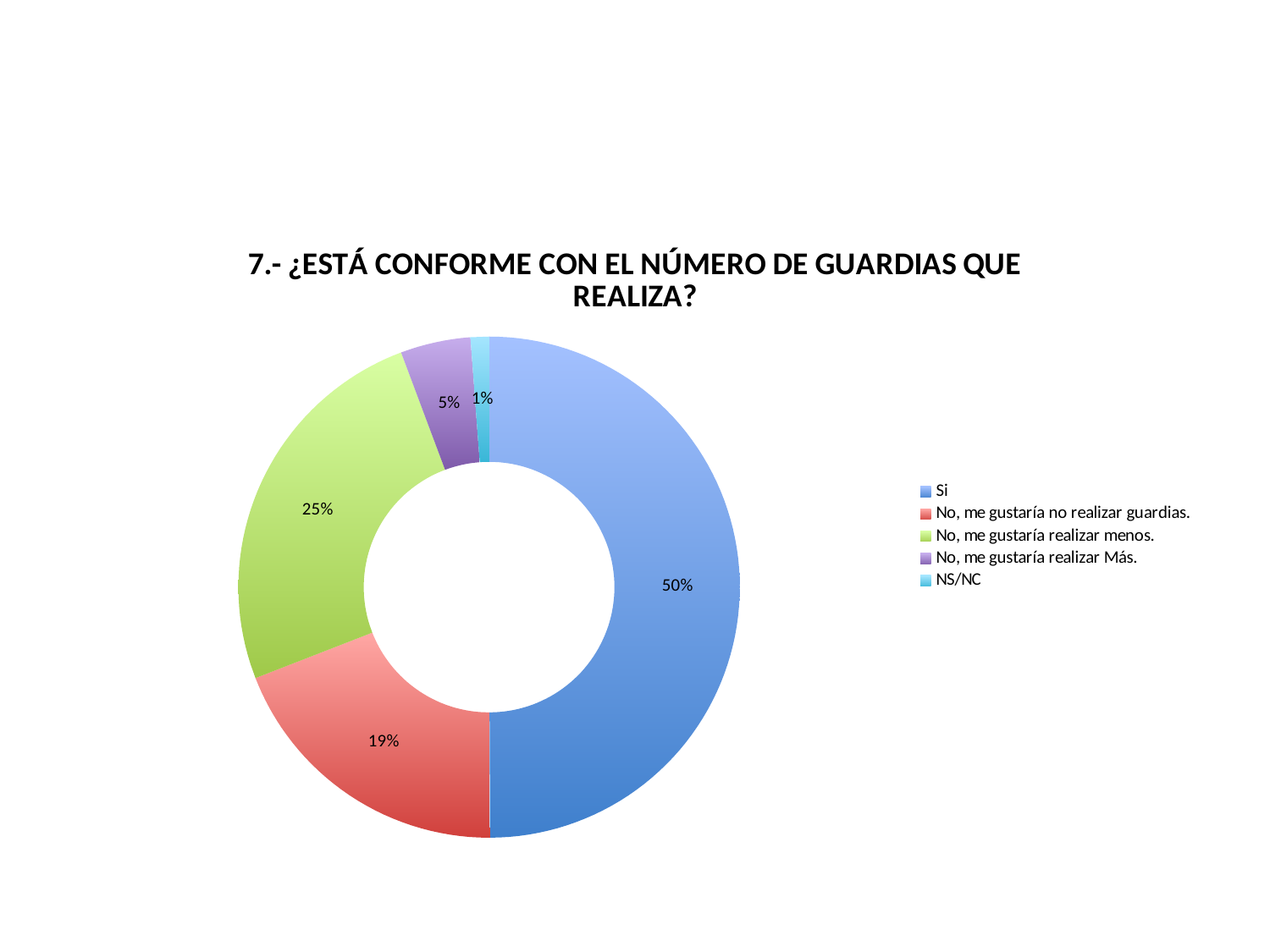
How many categories does the legend list? 5 What percentage of respondents answered "Si"? 50% What kind of chart is shown on the slide? Doughnut (pie) chart Which category has the largest share of the chart? Si What is the title of the chart? 7.- ¿ESTÁ CONFORME CON EL NÚMERO DE GUARDIAS QUE REALIZA? What is the difference in percentage points between "Si" and "No, me gustaría realizar menos."? 25 What share is shown for "No, me gustaría realizar menos."? 25% Which category has the smallest share of the chart? NS/NC What percentage is shown for "NS/NC"? 1% What colour represents "No, me gustaría realizar Más." in the chart? Purple Which is larger: the share for "No, me gustaría realizar menos." or for "No, me gustaría no realizar guardias."? No, me gustaría realizar menos. What percentage is shown for "No, me gustaría no realizar guardias."? 19%